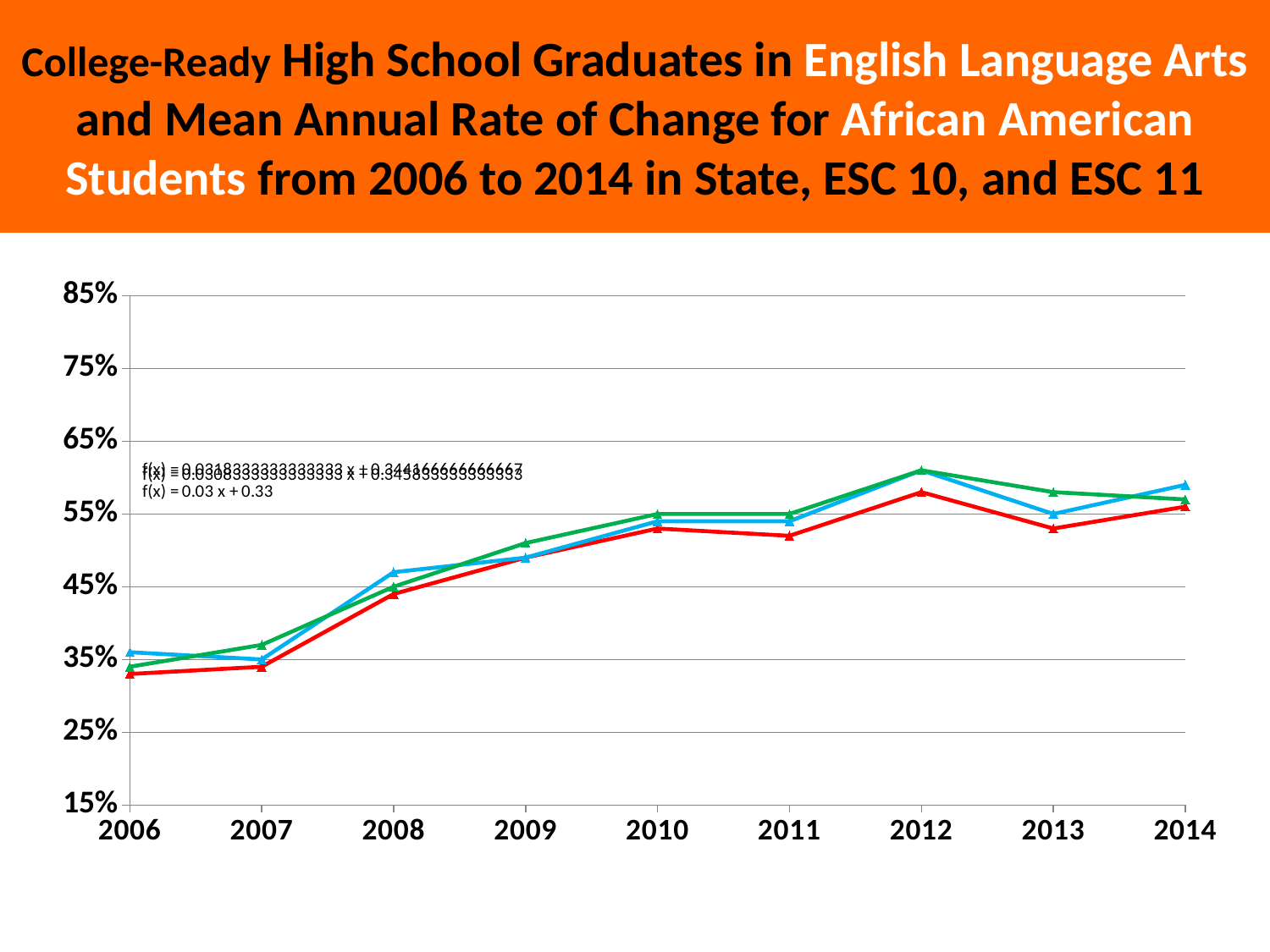
In which year is the green line at its lowest value? 2006 Overall, do the plotted values rise or fall from 2006 to 2014? rise What kind of chart is shown on the slide? line chart Is the value of the red line in 2011 greater or less than 55%? less What is the simplified trendline equation printed on the chart? f(x) = 0.03 x + 0.33 Is the value of the green line in 2012 greater or less than 55%? greater In which year does the green line reach its highest value? 2012 How many years are shown along the x axis of the chart? 9 How many lines are plotted on the chart? 3 Is the value of the red line in 2006 greater or less than 35%? less In which year does the red line reach its highest value? 2012 In 2013, which line has the higher value, the green line or the red line? green line